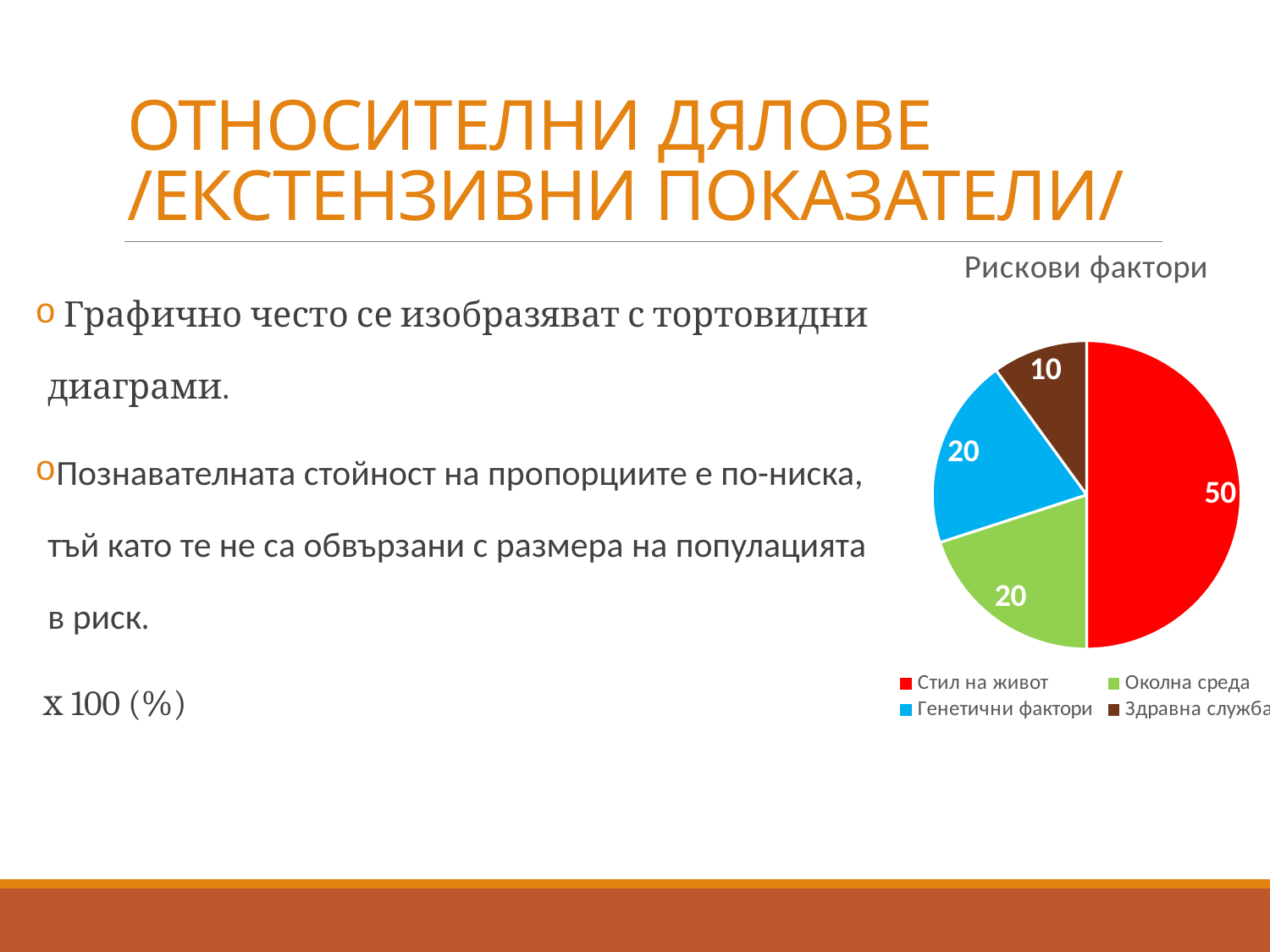
What is the value for Здравна служба in the pie chart? 10 What kind of chart is shown on the slide? pie chart How many categories does the pie chart show? 4 What share of the pie does Стил на живот represent? 50% What is the difference between the values for Стил на живот and Здравна служба? 40 Which is larger, the value for Стил на живот or the value for Околна среда? Стил на живот What is the value for Околна среда in the pie chart? 20 Which category has the smallest slice in the pie chart? Здравна служба What is the value for Генетични фактори in the pie chart? 20 What is the title of the chart? Рискови фактори Which category has the largest slice in the pie chart? Стил на живот What is the value for Стил на живот in the pie chart? 50